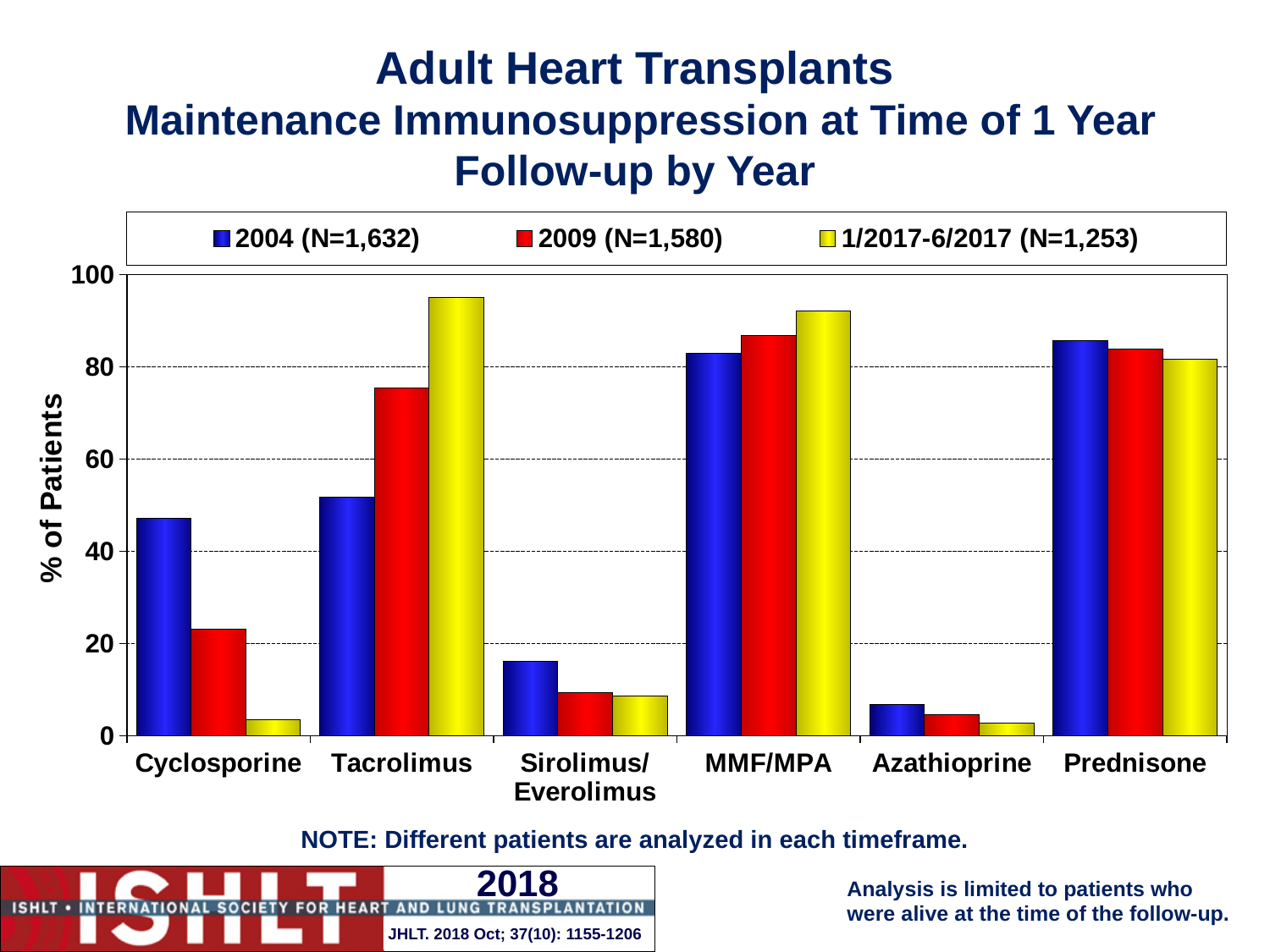
How many series does the legend list? 3 For Cyclosporine, which is larger: the 2004 value or the 2009 value? 2004 Do the values for Cyclosporine rise or fall from 2004 to 1/2017-6/2017? fall Is the value for Azathioprine in 2009 greater or less than 20? less Is the value for Cyclosporine in 2004 greater or less than 40? greater Is the value for Tacrolimus in 1/2017-6/2017 greater or less than 80? greater What is the label of the y axis? % of Patients Which drug category has the lowest value for the 2004 series? Azathioprine How many drug categories are shown on the x axis? 6 For Prednisone, which is larger: the 2004 value or the 1/2017-6/2017 value? 2004 Do the values for Tacrolimus rise or fall from 2004 to 1/2017-6/2017? rise What kind of chart is shown on the slide? bar chart